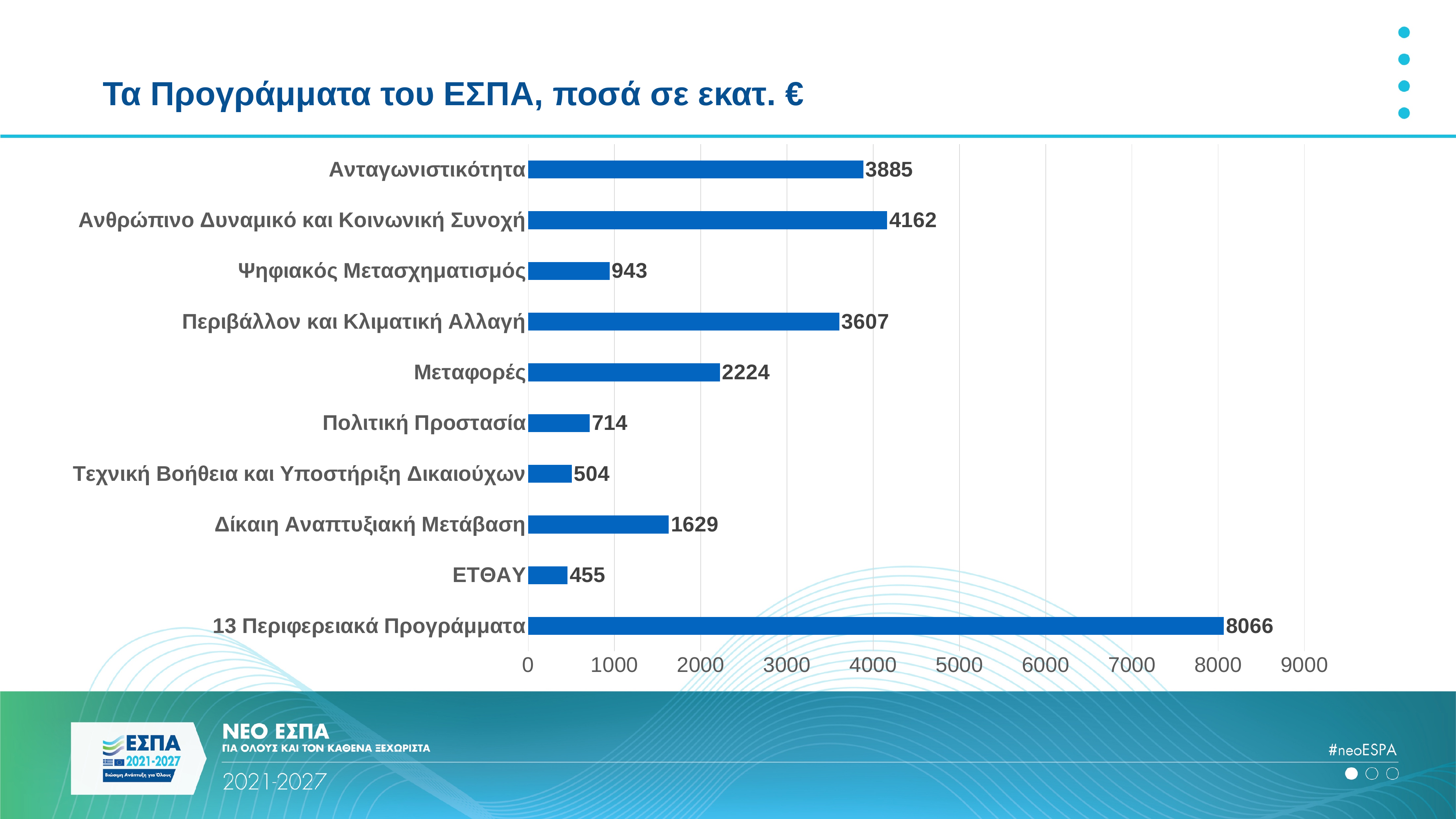
Which is larger, the value for Περιβάλλον και Κλιματική Αλλαγή or the value for Ανταγωνιστικότητα? Ανταγωνιστικότητα Which is larger, the value for Πολιτική Προστασία or the value for Τεχνική Βοήθεια και Υποστήριξη Δικαιούχων? Πολιτική Προστασία Which category has the highest value? 13 Περιφερειακά Προγράμματα What is the value for Ψηφιακός Μετασχηματισμός? 943 What is the difference between the values for Ανθρώπινο Δυναμικό και Κοινωνική Συνοχή and Ανταγωνιστικότητα? 277 How many categories are shown in the chart? 10 What is the value for ΕΤΘΑΥ? 455 Which category has the lowest value? ΕΤΘΑΥ What is the title of the slide? Τα Προγράμματα του ΕΣΠΑ, ποσά σε εκατ. € What is the value for Ανταγωνιστικότητα? 3885 What is the difference between the values for Μεταφορές and Δίκαιη Αναπτυξιακή Μετάβαση? 595 What kind of chart is shown on the slide? Bar chart